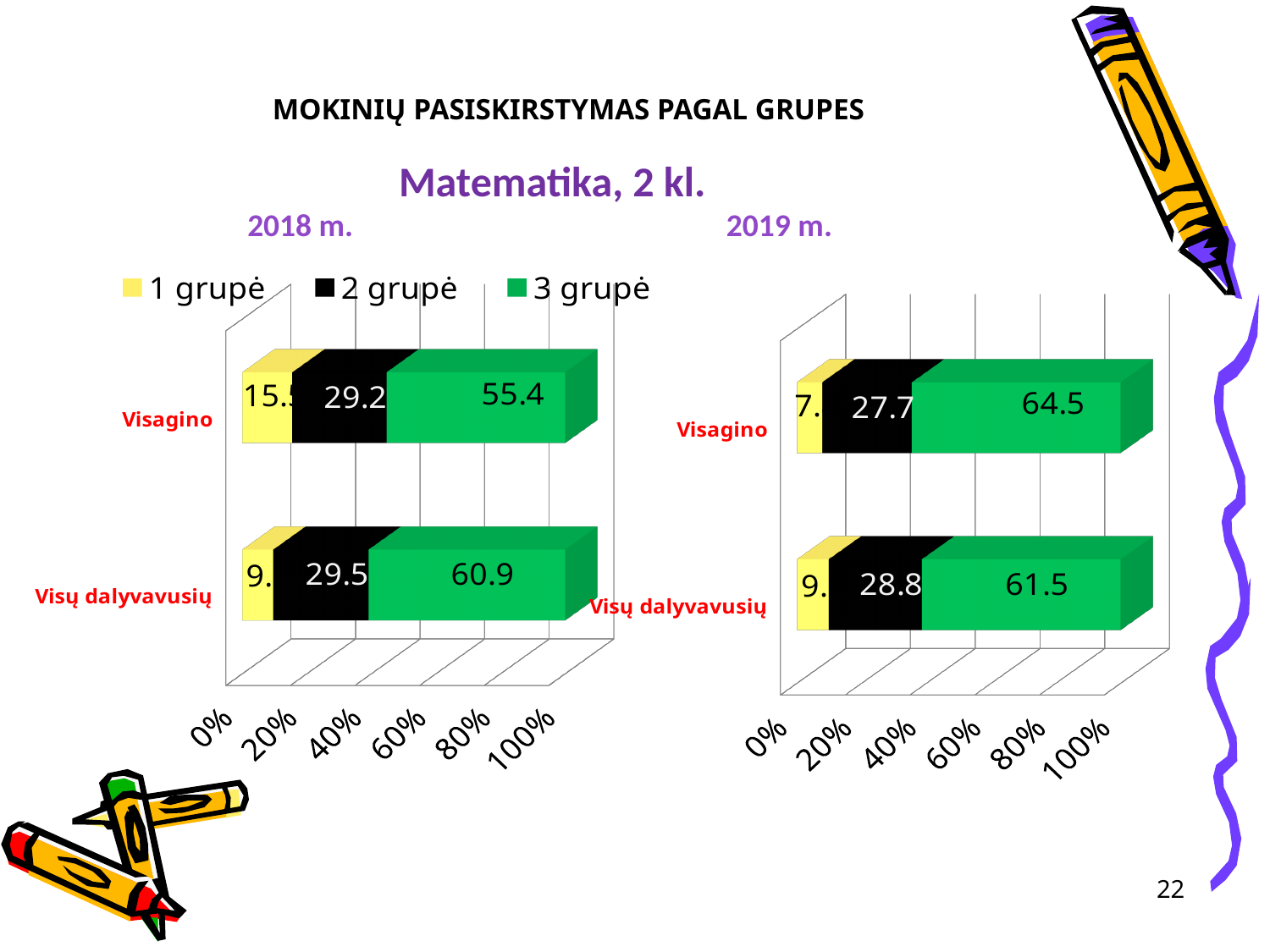
In the 2018 m. chart, what is the difference between the 3 grupė values for Visų dalyvavusių and Visagino? 5.5 In the 2019 m. chart, what is the value for 2 grupė for Visų dalyvavusių? 28.8 In the 2018 m. chart, what is the value for 2 grupė for Visų dalyvavusių? 29.5 In the 2019 m. chart, which category has the larger 3 grupė value, Visagino or Visų dalyvavusių? Visagino In the 2019 m. chart, what is the value for 3 grupė for Visagino? 64.5 In the 2019 m. chart, what is the difference between the 3 grupė values for Visagino and Visų dalyvavusių? 3.0 In the 2018 m. chart, which category has the larger 3 grupė value, Visagino or Visų dalyvavusių? Visų dalyvavusių How many categories are shown in the 2019 m. chart? 2 What kind of chart is the 2018 m. chart? Stacked bar chart In the 2019 m. chart, what is the value for 2 grupė for Visagino? 27.7 How many series does the legend list for the 2018 m. chart? 3 In the 2018 m. chart, what is the value for 3 grupė for Visagino? 55.4